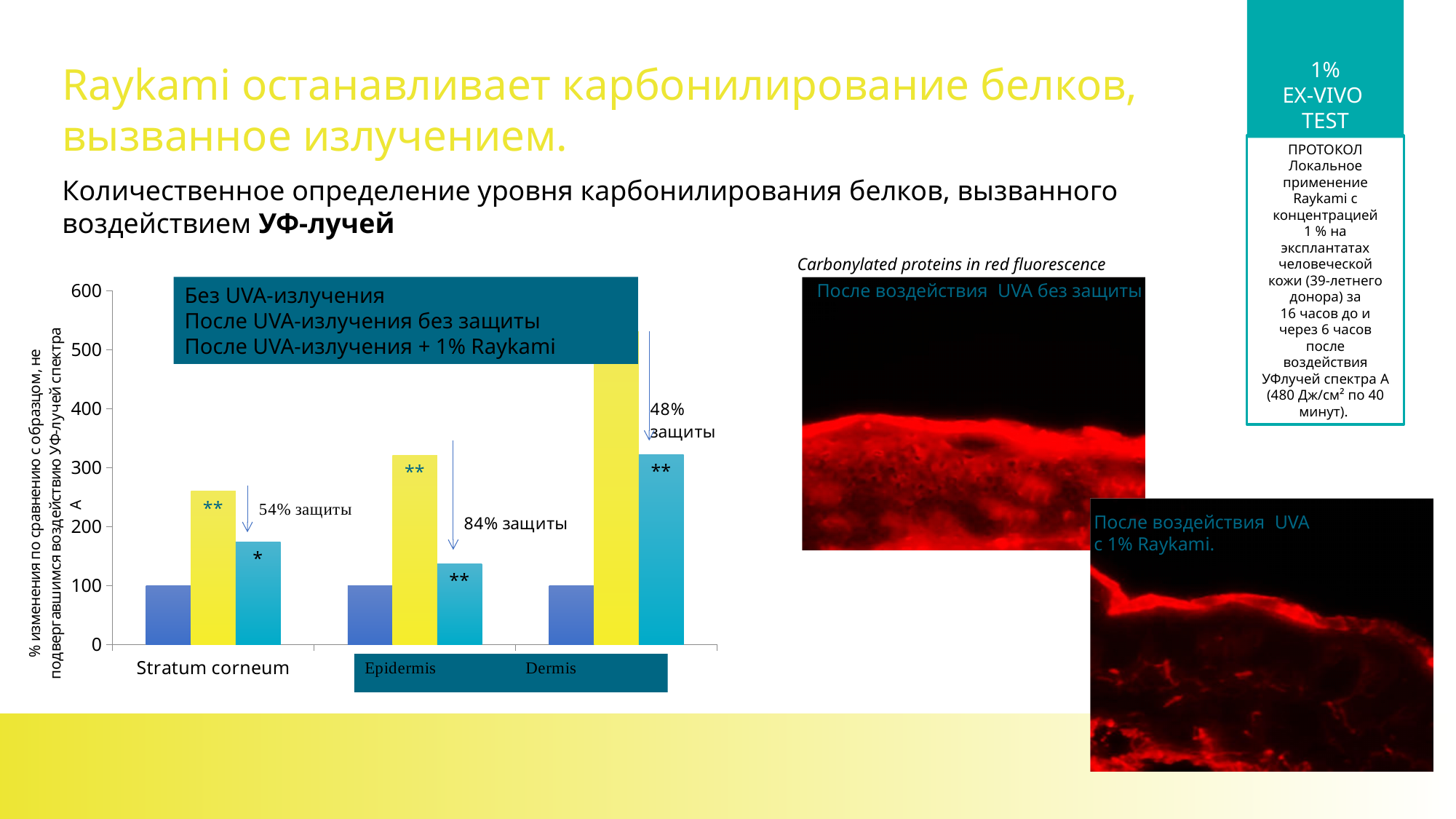
Which category has the highest value for После UVA-излучения без защиты? Dermis What is the value for Без UVA-излучения in the Stratum corneum category? 100 What protection percentage is annotated above the Epidermis bars? 84% защиты Which is larger: the value for После UVA-излучения без защиты in Epidermis or in Stratum corneum? Epidermis How many skin layer categories are shown on the x axis of the bar chart? 3 How many series does the legend of the bar chart list? 3 Is the value for После UVA-излучения без защиты in Epidermis greater or less than 300? greater Which category has the lowest value for После UVA-излучения + 1% Raykami? Epidermis Is the value for После UVA-излучения + 1% Raykami in Stratum corneum greater or less than 200? less What kind of chart is shown on the slide? bar chart What protection percentage is annotated next to the Dermis bars? 48% защиты Is the value for После UVA-излучения без защиты in Dermis greater or less than 400? greater